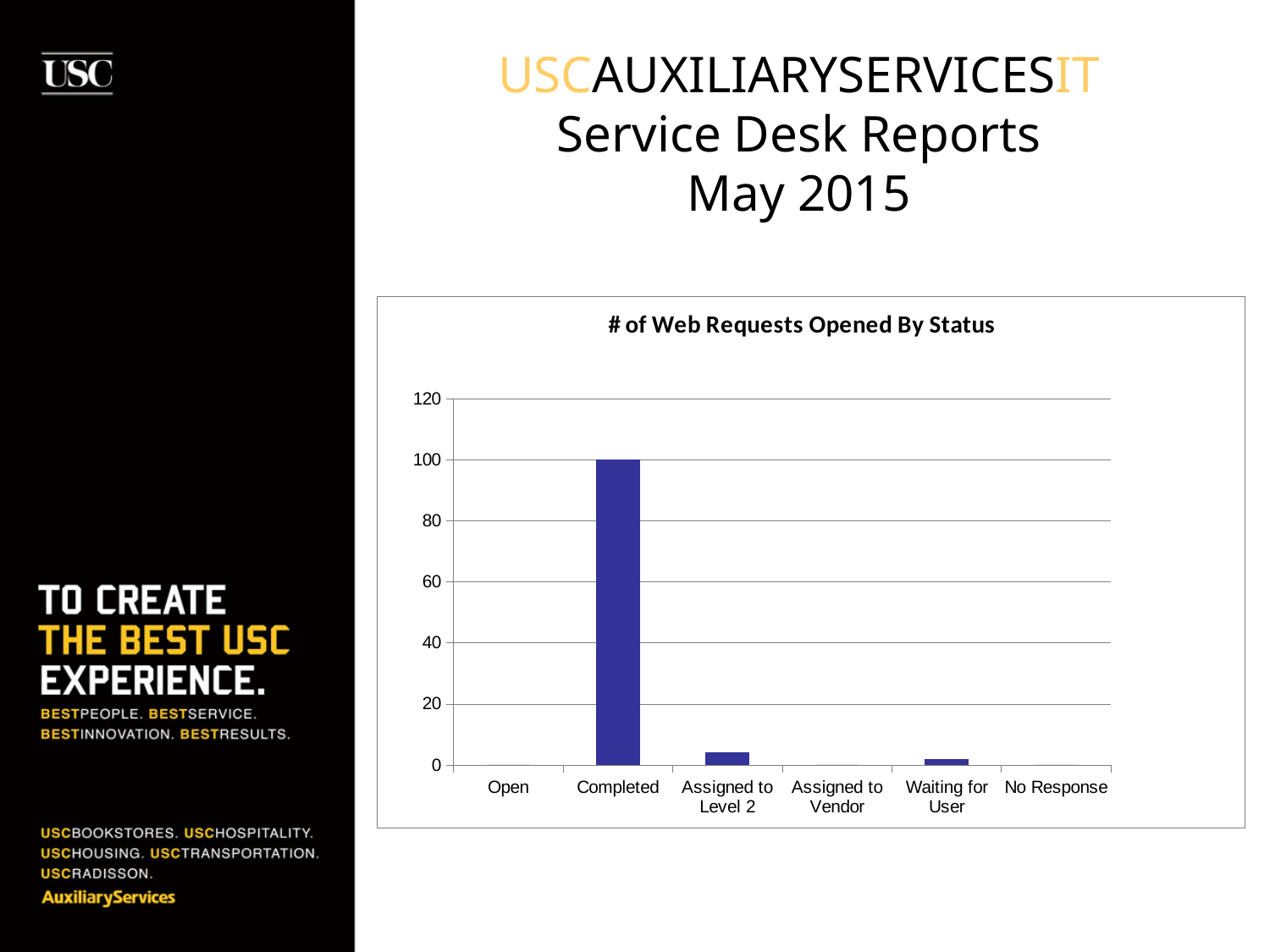
What is the title of the chart? # of Web Requests Opened By Status How many status categories are shown on the x axis of the chart? 6 Is the value for Assigned to Level 2 greater or less than 20? less What type of chart is shown on the slide? bar chart Which is larger, the value for Completed or the value for Assigned to Level 2? Completed What is the highest value shown on the y axis of the chart? 120 Is the value for Waiting for User greater or less than 20? less Which is larger, the value for Assigned to Level 2 or the value for Waiting for User? Assigned to Level 2 Is the value for Completed greater or less than 80? greater Which status has the highest number of web requests? Completed